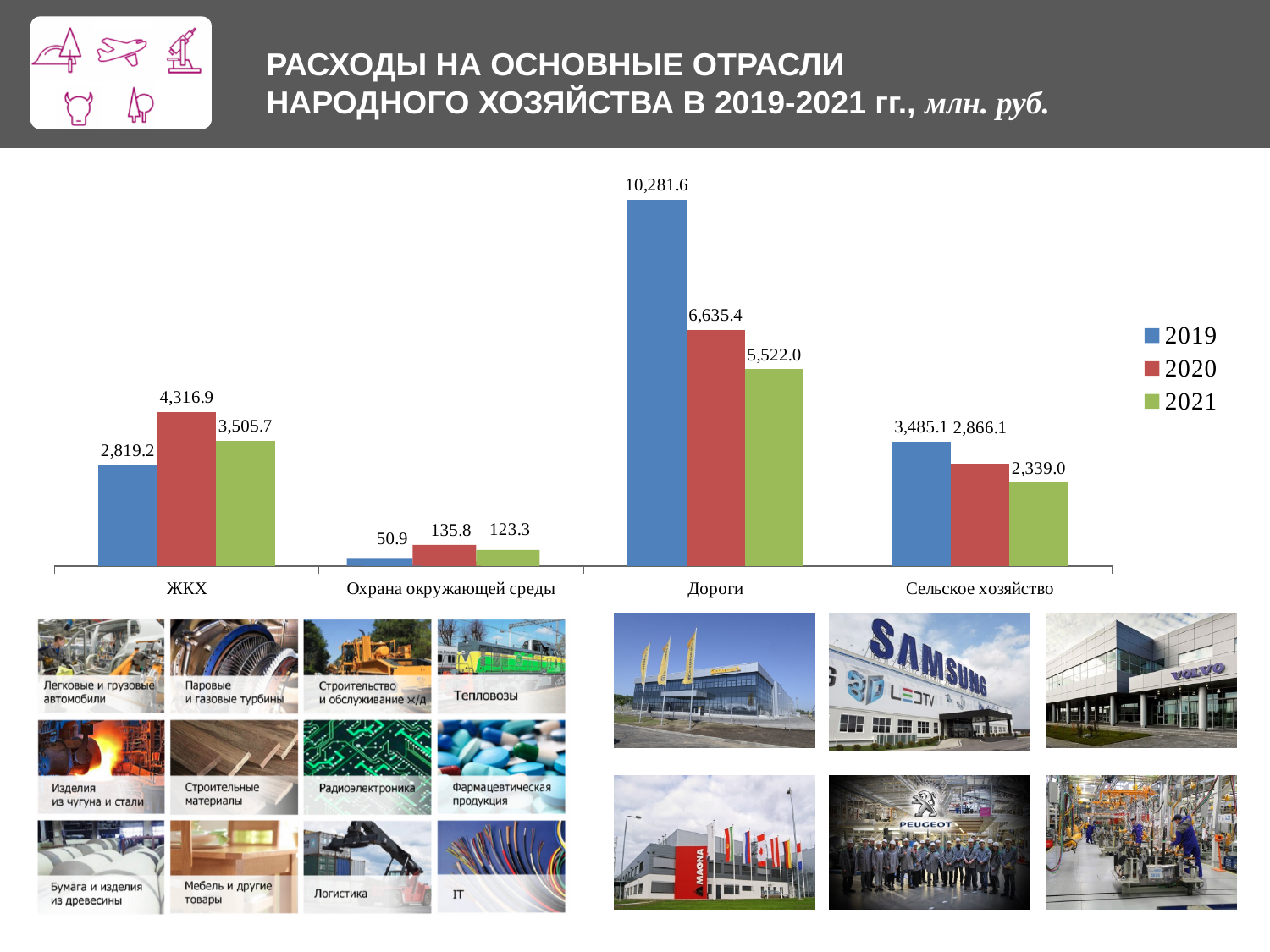
Which category has the lowest value in 2020? Охрана окружающей среды What is the value for Сельское хозяйство in 2021? 2,339.0 How many series does the legend list? 3 What is the value for ЖКХ in 2020? 4,316.9 Which is larger for ЖКХ: the 2019 value or the 2021 value? 2021 What type of chart is shown on the slide? bar chart What is the difference between the 2019 and 2020 values for Дороги? 3,646.2 How many categories are shown on the x axis? 4 What is the value for Охрана окружающей среды in 2021? 123.3 Do the values for Сельское хозяйство rise or fall from 2019 to 2021? fall Which category has the highest value in 2019? Дороги What is the value for Дороги in 2019? 10,281.6